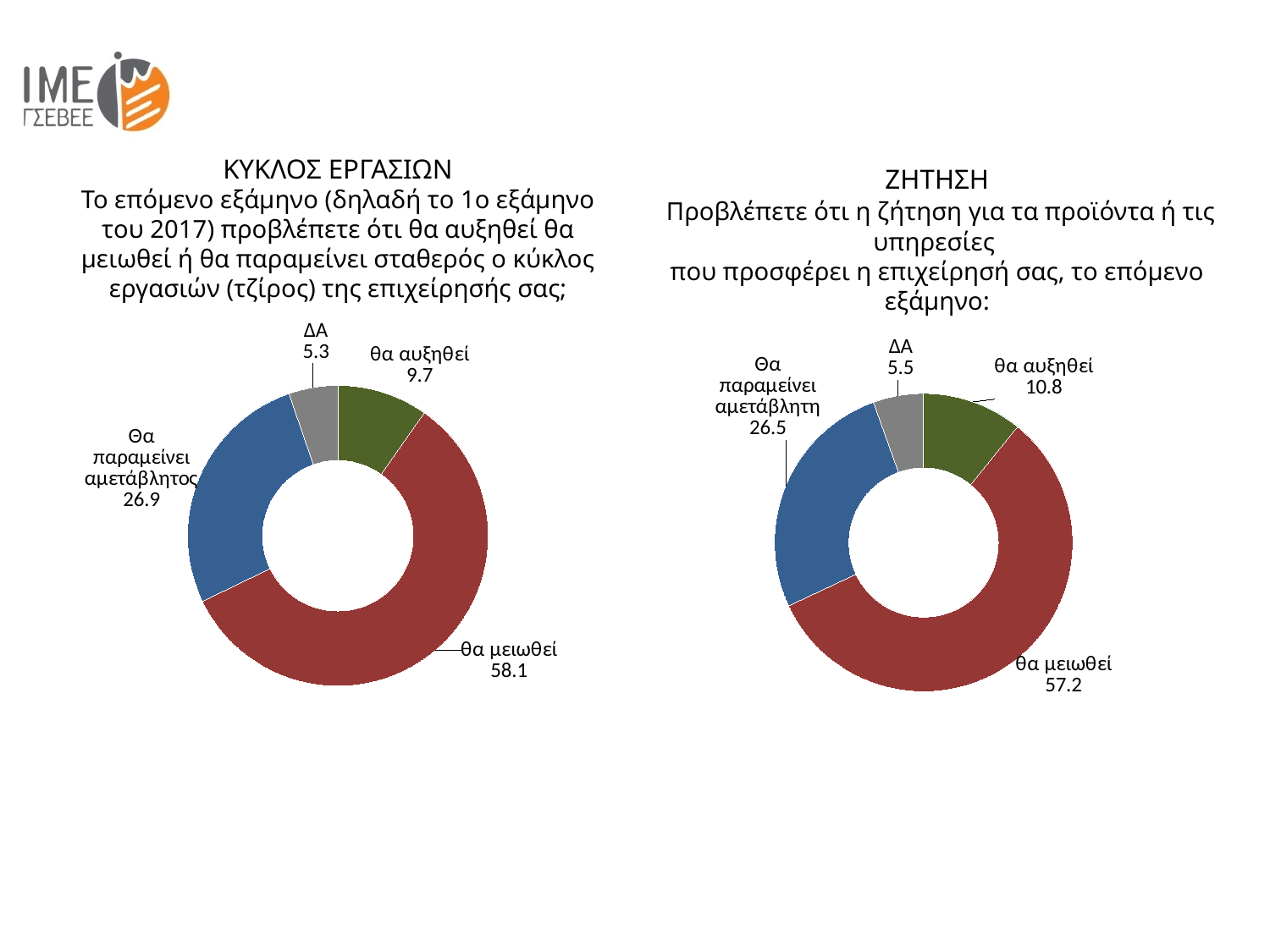
How many categories does the ΖΗΤΗΣΗ chart show? 4 What type of chart is the ΚΥΚΛΟΣ ΕΡΓΑΣΙΩΝ chart? Doughnut (pie) chart In the ΚΥΚΛΟΣ ΕΡΓΑΣΙΩΝ chart, what is the value for 'Θα παραμείνει αμετάβλητος'? 26.9 In the ΚΥΚΛΟΣ ΕΡΓΑΣΙΩΝ chart, what is the value for 'θα μειωθεί'? 58.1 In the ΚΥΚΛΟΣ ΕΡΓΑΣΙΩΝ chart, what colour is the 'θα μειωθεί' slice? Red In the ΚΥΚΛΟΣ ΕΡΓΑΣΙΩΝ chart, what is the difference between 'θα μειωθεί' and 'Θα παραμείνει αμετάβλητος'? 31.2 In the ΖΗΤΗΣΗ chart, what is the value for 'θα αυξηθεί'? 10.8 Which is larger: 'θα αυξηθεί' in the ΚΥΚΛΟΣ ΕΡΓΑΣΙΩΝ chart or 'θα αυξηθεί' in the ΖΗΤΗΣΗ chart? ΖΗΤΗΣΗ (10.8) In the ΖΗΤΗΣΗ chart, what is the value for 'ΔΑ'? 5.5 In the ΚΥΚΛΟΣ ΕΡΓΑΣΙΩΝ chart, which category has the largest share? θα μειωθεί In the ΖΗΤΗΣΗ chart, what is the difference between 'θα μειωθεί' and 'θα αυξηθεί'? 46.4 In the ΖΗΤΗΣΗ chart, which category has the smallest share? ΔΑ